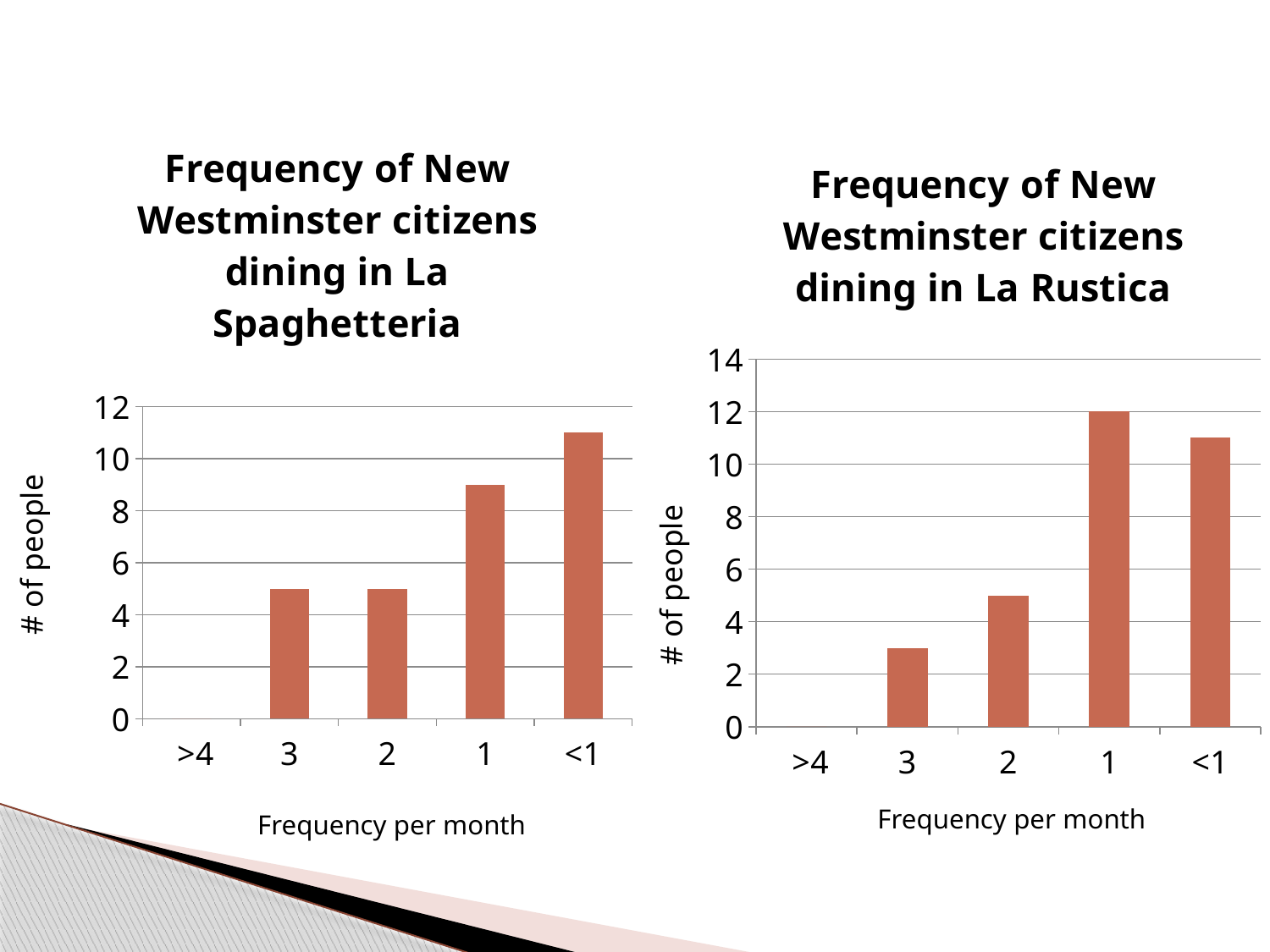
In the La Spaghetteria chart, which is larger, the value for '1' or the value for '2'? 1 In the La Rustica chart, is the value for '<1' greater or less than 10? greater In the La Rustica chart, which frequency category has the highest number of people? 1 What kind of chart is the 'Frequency of New Westminster citizens dining in La Spaghetteria' chart? bar chart In the La Spaghetteria chart, is the value for '3' greater or less than 6? less How many frequency categories are shown on the x axis of the La Rustica chart? 5 In the La Spaghetteria chart, which frequency category has the highest number of people? <1 What is the y-axis label on the La Rustica chart? # of people In the La Rustica chart, what is the number of people for the frequency category '1'? 12 In the La Spaghetteria chart, what is the number of people for the frequency category '>4'? 0 In the La Rustica chart, is the value for '3' greater or less than 2? greater